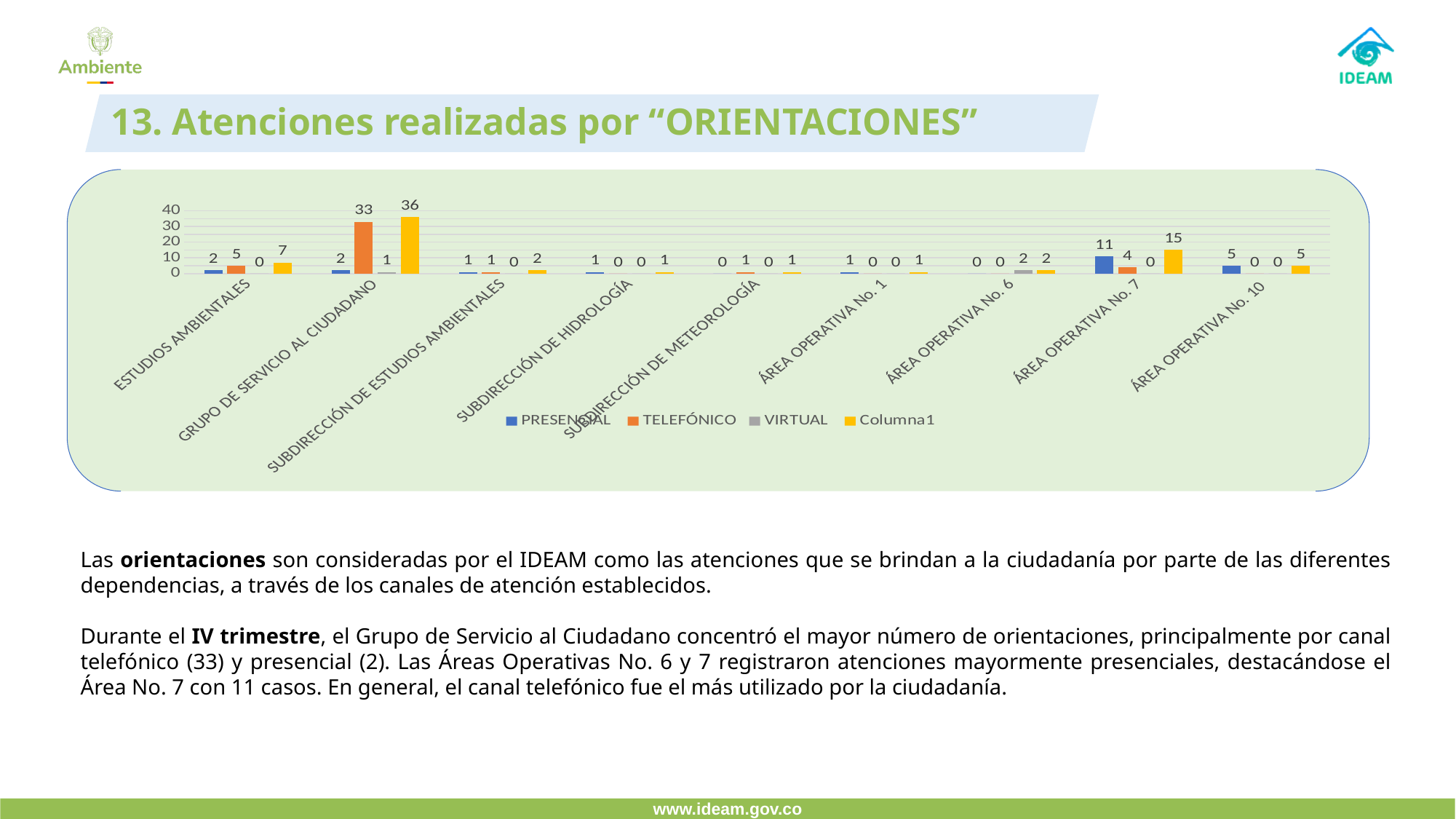
What is the TELEFÓNICO value for GRUPO DE SERVICIO AL CIUDADANO? 33 What is the PRESENCIAL value for ÁREA OPERATIVA No. 7? 11 Which is larger: the PRESENCIAL value for ÁREA OPERATIVA No. 10 or the PRESENCIAL value for ESTUDIOS AMBIENTALES? ÁREA OPERATIVA No. 10 Which category has the highest PRESENCIAL value? ÁREA OPERATIVA No. 7 What kind of chart is shown on the slide? bar chart What is the Columna1 value for ESTUDIOS AMBIENTALES? 7 What is the VIRTUAL value for ÁREA OPERATIVA No. 6? 2 Which category has the highest Columna1 value? GRUPO DE SERVICIO AL CIUDADANO What is the difference between the Columna1 value for GRUPO DE SERVICIO AL CIUDADANO and the Columna1 value for ÁREA OPERATIVA No. 7? 21 How many categories are shown on the x axis of the chart? 9 How many series does the chart legend list? 4 Which series is shown in yellow in the chart legend? Columna1